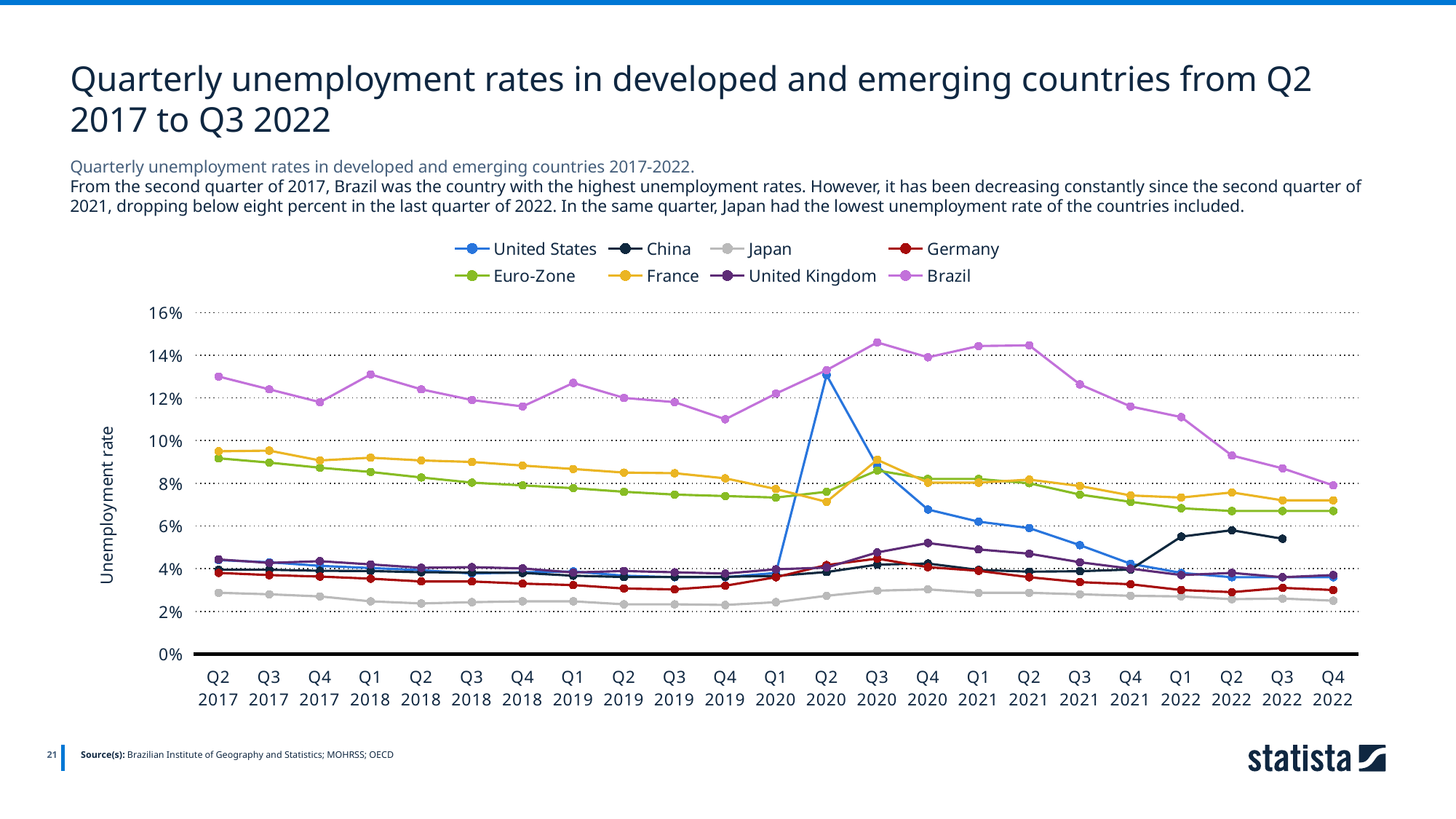
Does Brazil's unemployment rate rise or fall from Q2 2021 to Q4 2022? Fall Is the value for the Euro-Zone in Q4 2022 greater or less than 8%? less In Q3 2022, which had the higher unemployment rate, China or the United States? China How many quarters are plotted along the x axis? 23 How many series does the legend list? 8 Is the value for Japan in Q2 2017 greater or less than 4%? less Is the value for the United States in Q2 2020 greater or less than 12%? greater What type of chart is shown on the slide? Line chart Which country had the lowest unemployment rate in Q4 2022? Japan Which country had the highest unemployment rate in Q3 2020? Brazil What is the label on the y axis? Unemployment rate